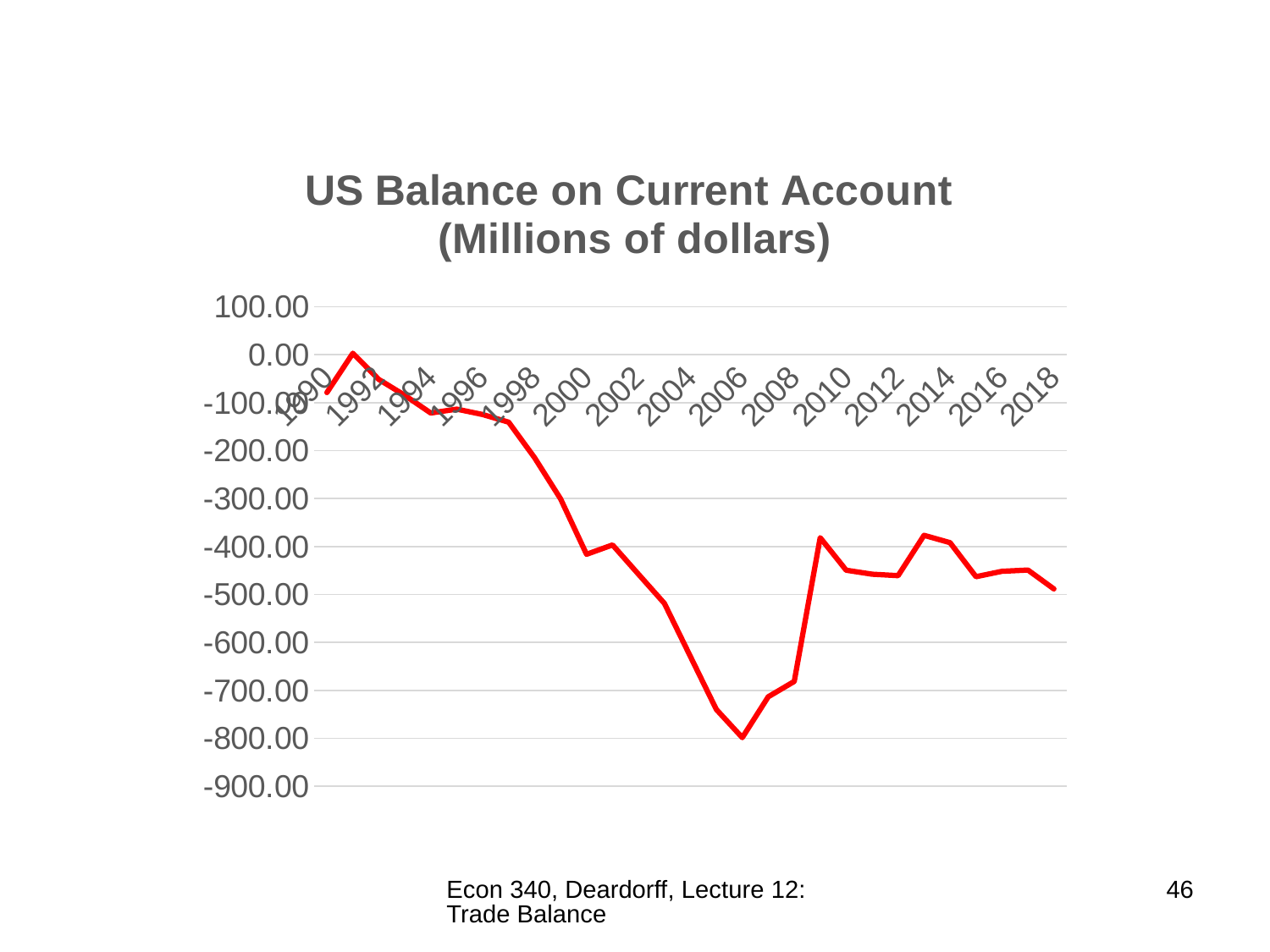
Is the value for 2004 greater or less than -600.00? less Is the value for 2018 greater or less than -400.00? less Does the balance on current account rise or fall between 1998 and 2006? fall Is the value for 1998 greater or less than -300.00? greater What is the title of the chart? US Balance on Current Account (Millions of dollars) In which year is the US balance on current account at its highest? 1991 Which year has the larger balance on current account, 2006 or 2009? 2009 How many year labels are shown on the x axis? 15 What colour is the line plotted in the chart? red In which year does the US balance on current account reach its lowest value? 2006 What kind of chart is shown on the slide? line chart